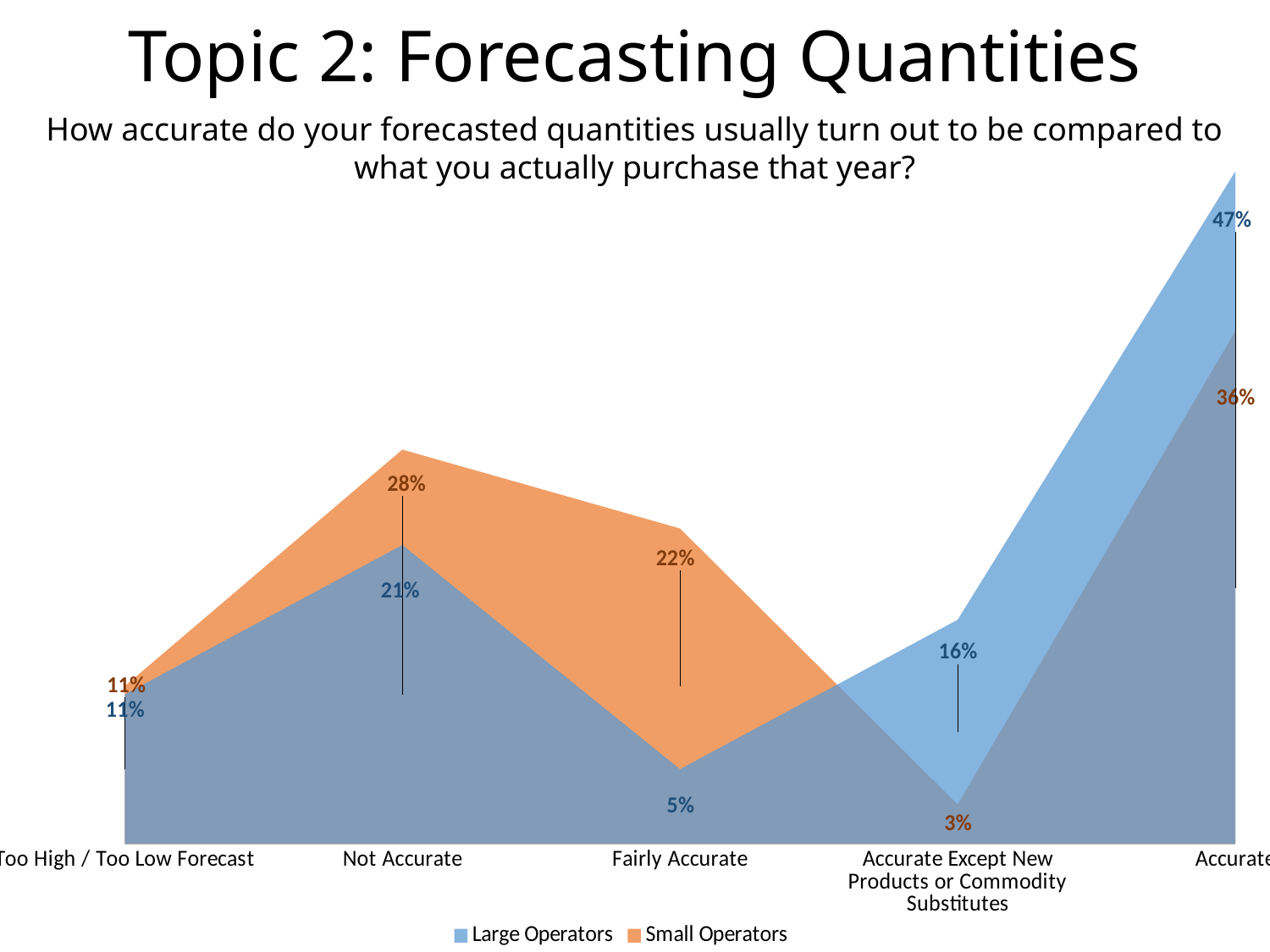
Which series is shown in orange in the legend? Small Operators Which category has the lowest value for Large Operators? Fairly Accurate In the Fairly Accurate category, which series has the larger value, Large Operators or Small Operators? Small Operators What is the value for Large Operators in the Fairly Accurate category? 5% How many categories are shown along the x axis? 5 What is the difference between Large Operators and Small Operators in the Accurate category? 11% What is the value for Large Operators in the Accurate category? 47% How many series does the legend list? 2 What is the value for Small Operators in the Not Accurate category? 28% What kind of chart is shown on the slide? Area chart What is the value for Small Operators in the Accurate Except New Products or Commodity Substitutes category? 3% Which category has the highest value for Small Operators? Accurate